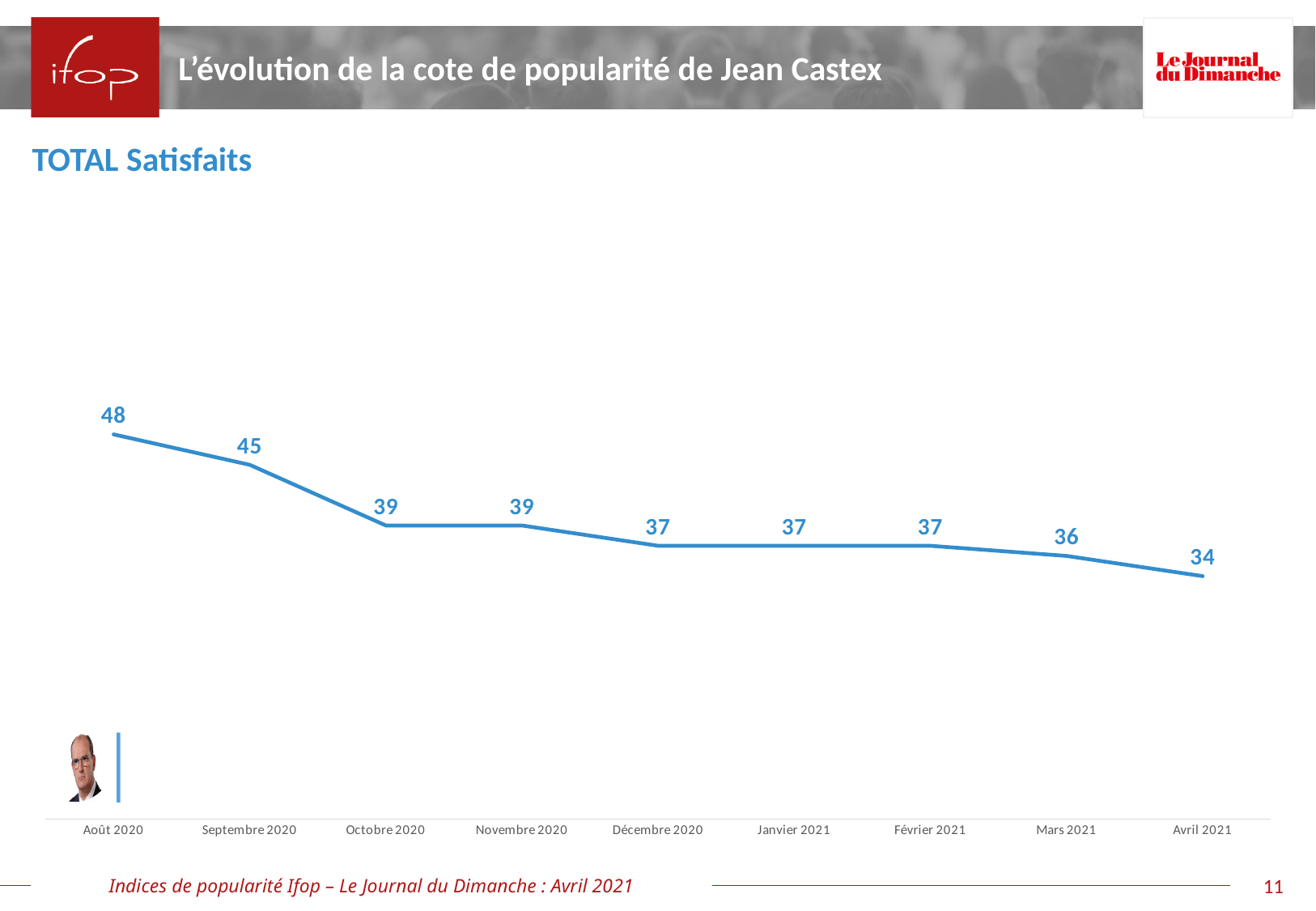
Which month has the highest value? Août 2020 What is the value for Mars 2021? 36 Do the values rise or fall from Août 2020 to Avril 2021? Fall What is the value for Avril 2021? 34 What is the value for Décembre 2020? 37 Which month has the lowest value? Avril 2021 What is the value for Août 2020? 48 What is the difference between the values for Septembre 2020 and Octobre 2020? 6 What is the difference between the values for Août 2020 and Avril 2021? 14 What kind of chart is shown? Line chart Which is larger, the value for Novembre 2020 or the value for Février 2021? Novembre 2020 How many months are plotted on the chart? 9